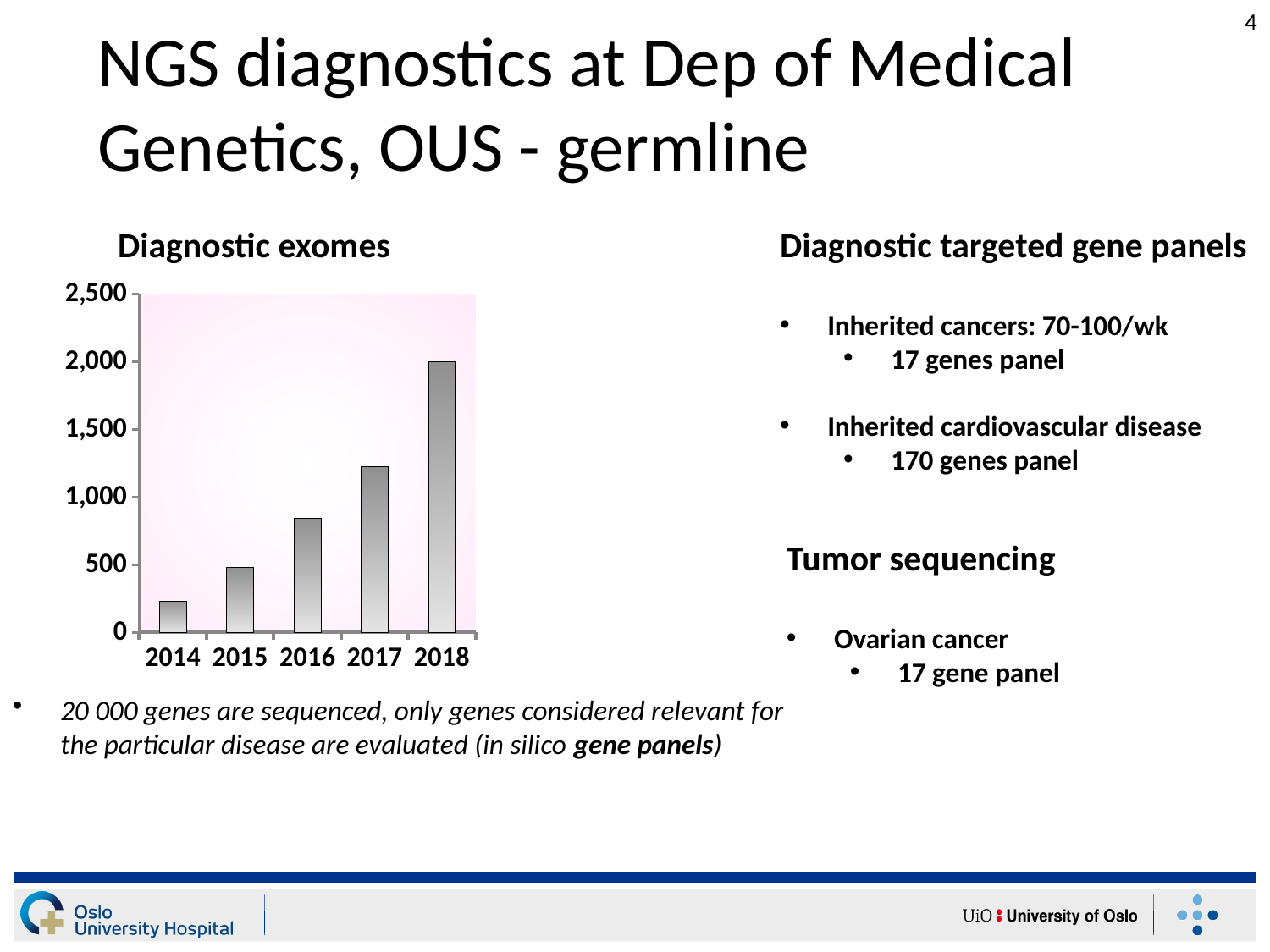
What is the highest value shown on the y axis of the Diagnostic exomes chart? 2,500 Do the values in the Diagnostic exomes chart rise or fall from 2014 to 2018? rise What kind of chart is the Diagnostic exomes chart? bar chart What is the title of the bar chart on the slide? Diagnostic exomes Which year has the lowest value in the Diagnostic exomes chart? 2014 In the Diagnostic exomes chart, is the value for 2017 greater or less than 1,500? less In the Diagnostic exomes chart, which year has the larger value, 2016 or 2017? 2017 Which year has the highest value in the Diagnostic exomes chart? 2018 How many years are shown on the x axis of the Diagnostic exomes chart? 5 In the Diagnostic exomes chart, is the value for 2017 greater or less than 1,000? greater In the Diagnostic exomes chart, is the value for 2016 greater or less than 500? greater